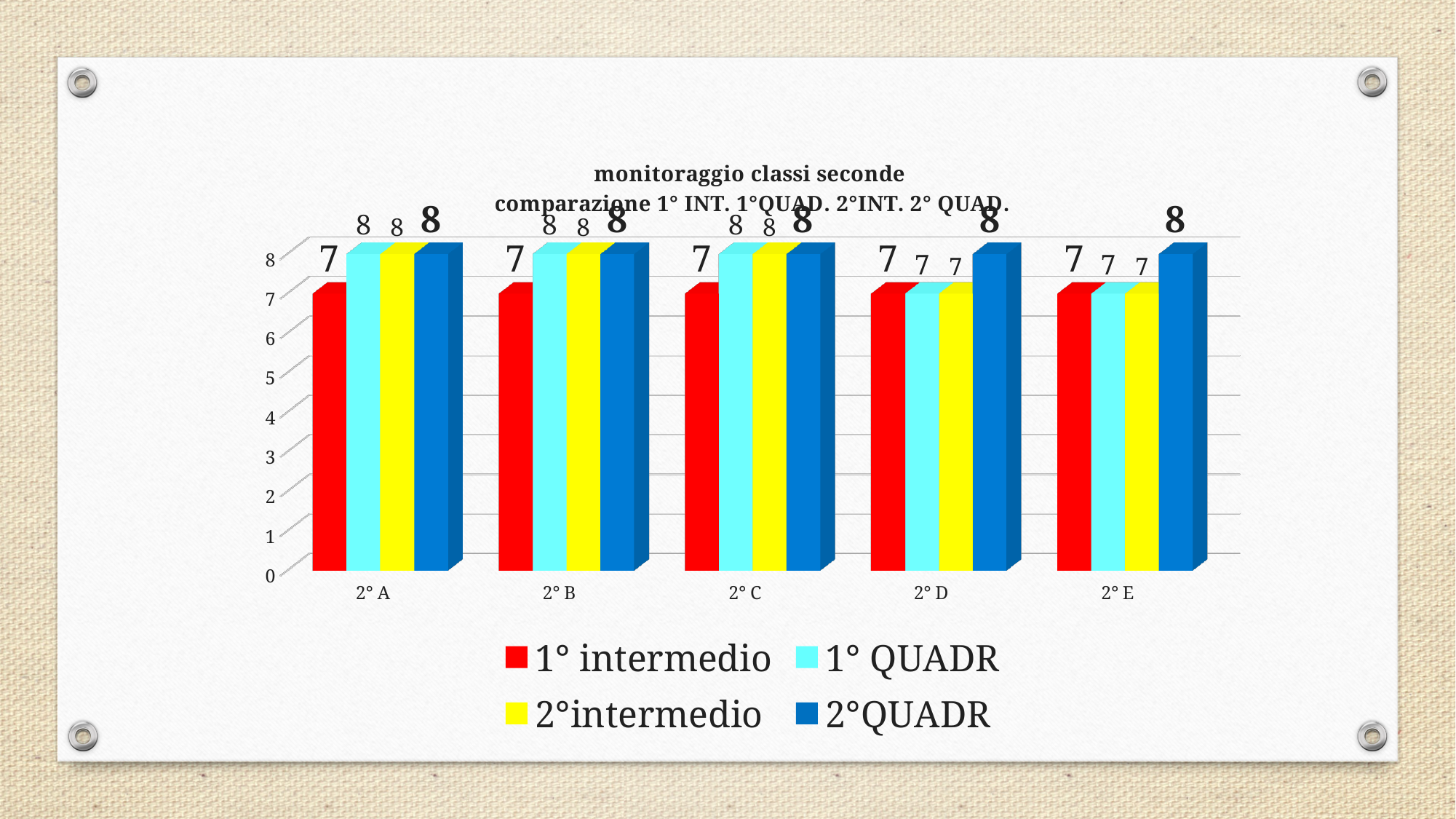
What is the difference between the 2°QUADR value and the 1° intermedio value for class 2° C? 1 Which colour represents the 2°QUADR series in the legend? Blue What is the value for 2°QUADR in class 2° E? 8 What is the first line of the chart title? monitoraggio classi seconde How many classes are shown on the x axis? 5 Which is larger for class 2° D: the 2°intermedio value or the 2°QUADR value? 2°QUADR How many series does the legend list? 4 What is the value for 1° intermedio in class 2° A? 7 What is the value for 2°intermedio in class 2° B? 8 Does the 1° intermedio value change across the classes from 2° A to 2° E? No, it stays at 7 What is the value for 1° QUADR in class 2° D? 7 What kind of chart is shown on the slide? Bar chart